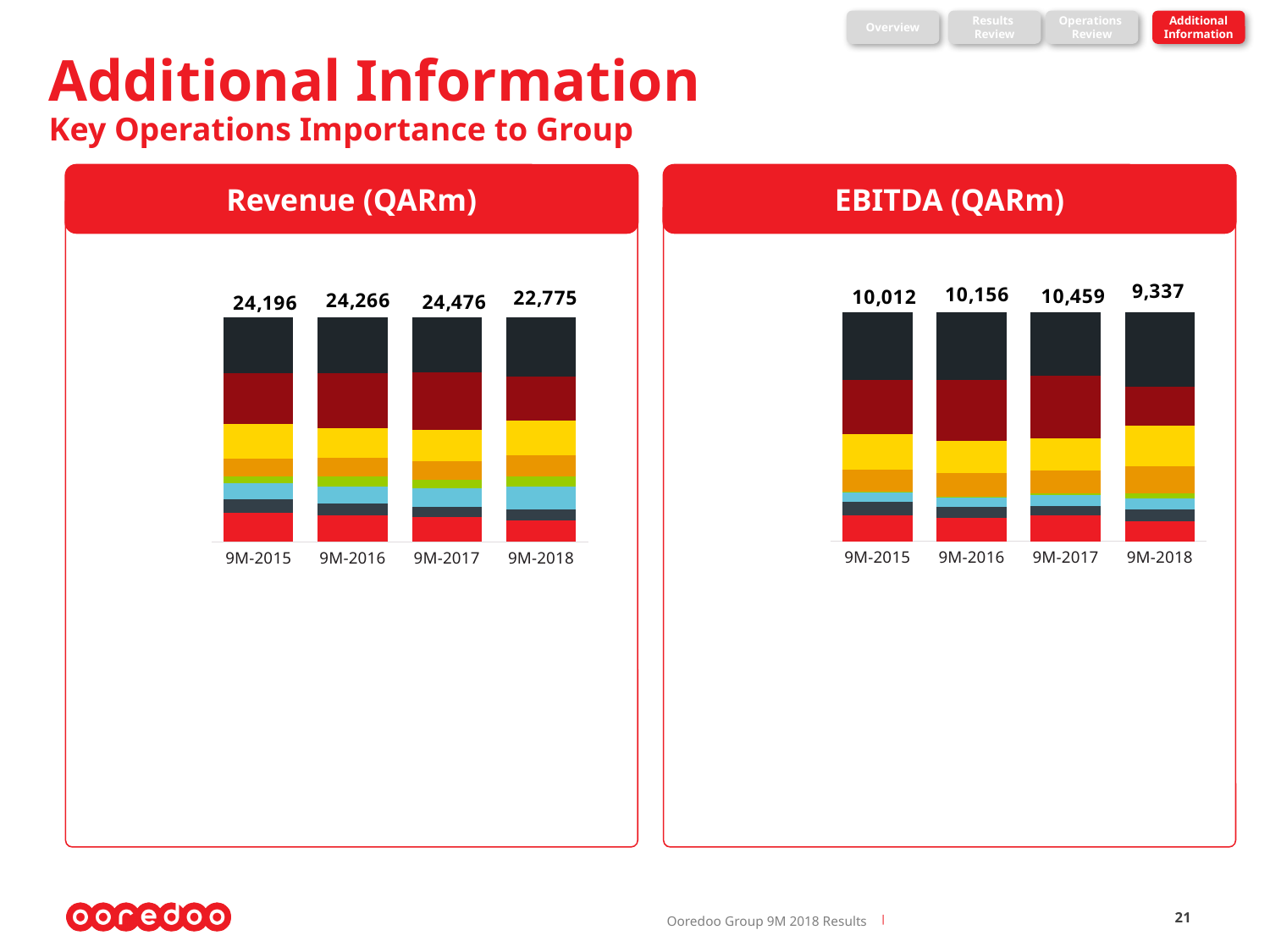
In the Revenue (QARm) chart, which period has the highest total revenue? 9M-2017 What kind of chart is the EBITDA (QARm) chart? Stacked bar chart In the EBITDA (QARm) chart, which is larger: the total for 9M-2015 or the total for 9M-2018? 9M-2015 In the Revenue (QARm) chart, what is the total revenue for 9M-2018? 22,775 In the Revenue (QARm) chart, what is the difference between the total revenue for 9M-2017 and 9M-2018? 1,701 In the EBITDA (QARm) chart, what is the difference between the total EBITDA for 9M-2016 and 9M-2015? 144 In the EBITDA (QARm) chart, which period has the lowest total EBITDA? 9M-2018 What is the title of the chart on the left side of the slide? Revenue (QARm) How many periods are shown on the x axis of the Revenue (QARm) chart? 4 In the EBITDA (QARm) chart, what is the total of the stacked bar for 9M-2016? 10,156 In the EBITDA (QARm) chart, what is the total EBITDA for 9M-2017? 10,459 In the Revenue (QARm) chart, does the total revenue rise or fall from 9M-2015 to 9M-2017? Rise